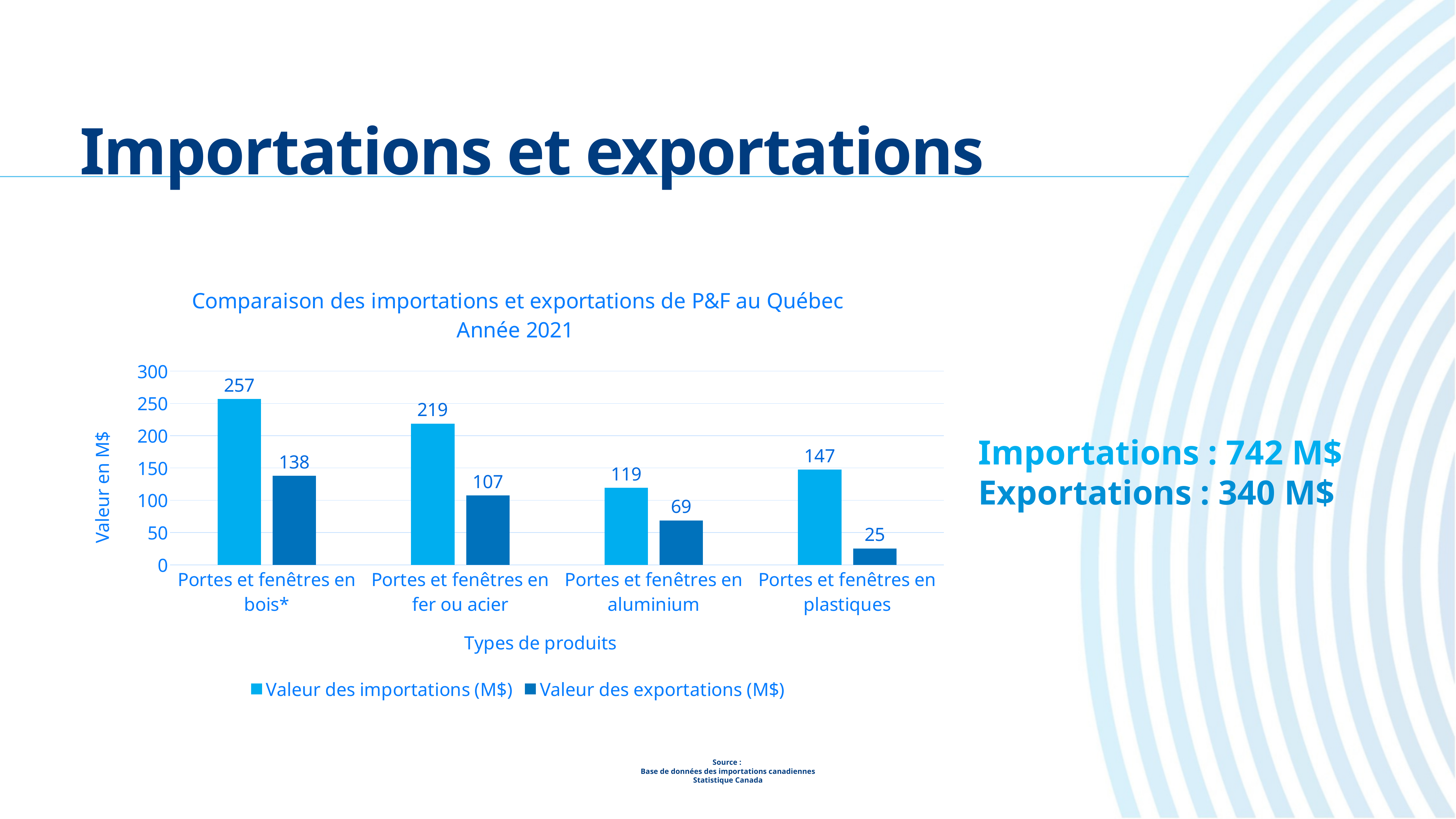
What is the value of exports (Valeur des exportations) for Portes et fenêtres en aluminium? 69 How many series does the legend list? 2 What is the difference between imports and exports for Portes et fenêtres en fer ou acier? 112 What is the value of imports (Valeur des importations) for Portes et fenêtres en bois*? 257 What kind of chart is shown on the slide? Bar chart Which product type has the highest import value? Portes et fenêtres en bois* How many product types are shown on the x axis? 4 What is the difference between the import value for Portes et fenêtres en bois* and the import value for Portes et fenêtres en fer ou acier? 38 What is the value of exports for Portes et fenêtres en plastiques? 25 Which product type has the lowest export value? Portes et fenêtres en plastiques Which is larger: the import value for Portes et fenêtres en aluminium or the import value for Portes et fenêtres en plastiques? Portes et fenêtres en plastiques What is the label of the y axis? Valeur en M$